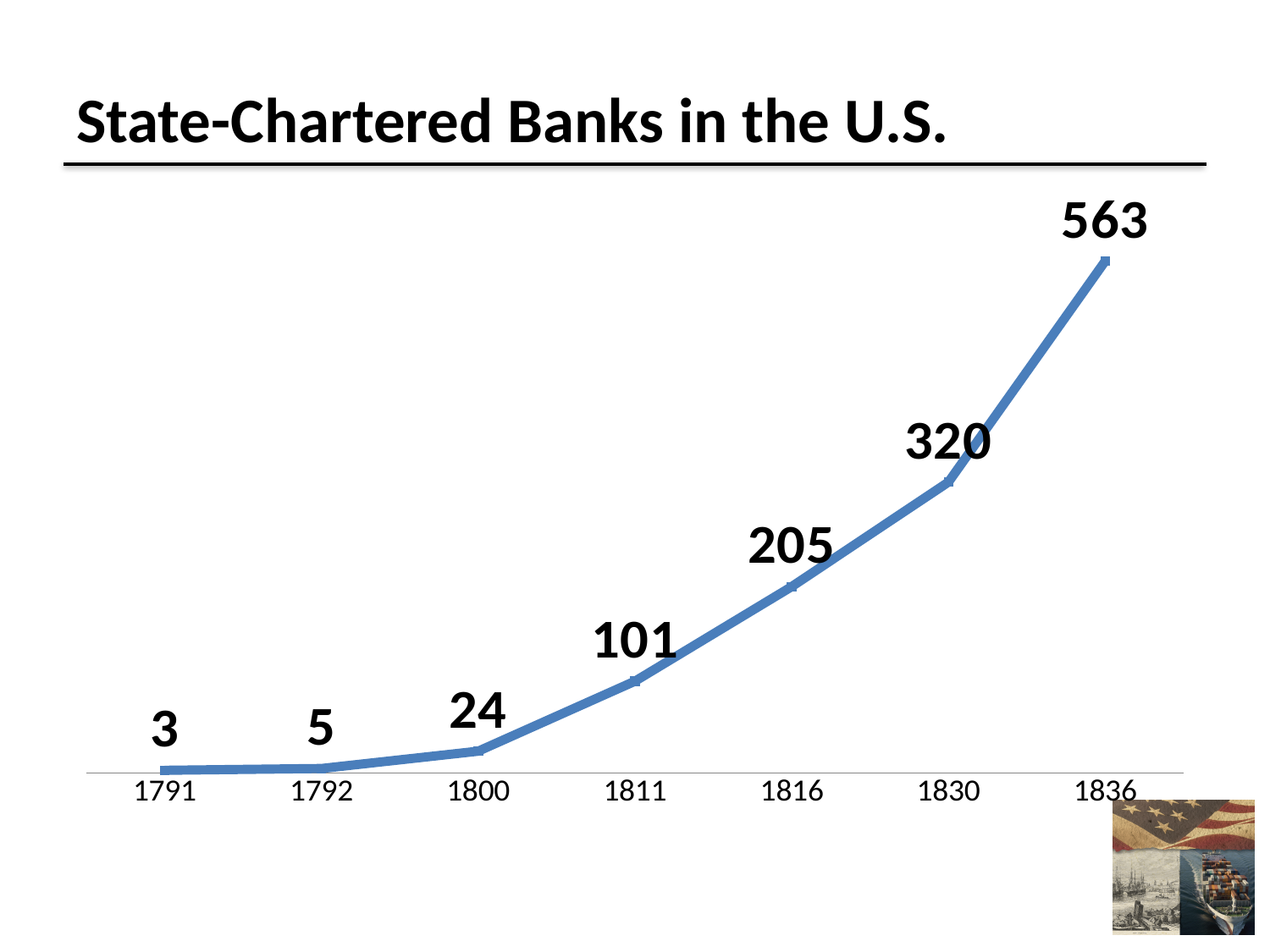
What is the difference between the number of banks in 1836 and in 1830? 243 What is the title of the chart? State-Chartered Banks in the U.S. What is the number of state-chartered banks in 1836? 563 Which year has the lowest number of state-chartered banks? 1791 What is the number of state-chartered banks in 1800? 24 What kind of chart is shown on the slide? line chart Which year has the highest number of state-chartered banks? 1836 What is the difference between the number of banks in 1816 and in 1811? 104 What is the number of state-chartered banks in 1811? 101 How many years are plotted on the chart? 7 Which year has more state-chartered banks, 1816 or 1830? 1830 Do the values rise or fall from 1791 to 1836? rise